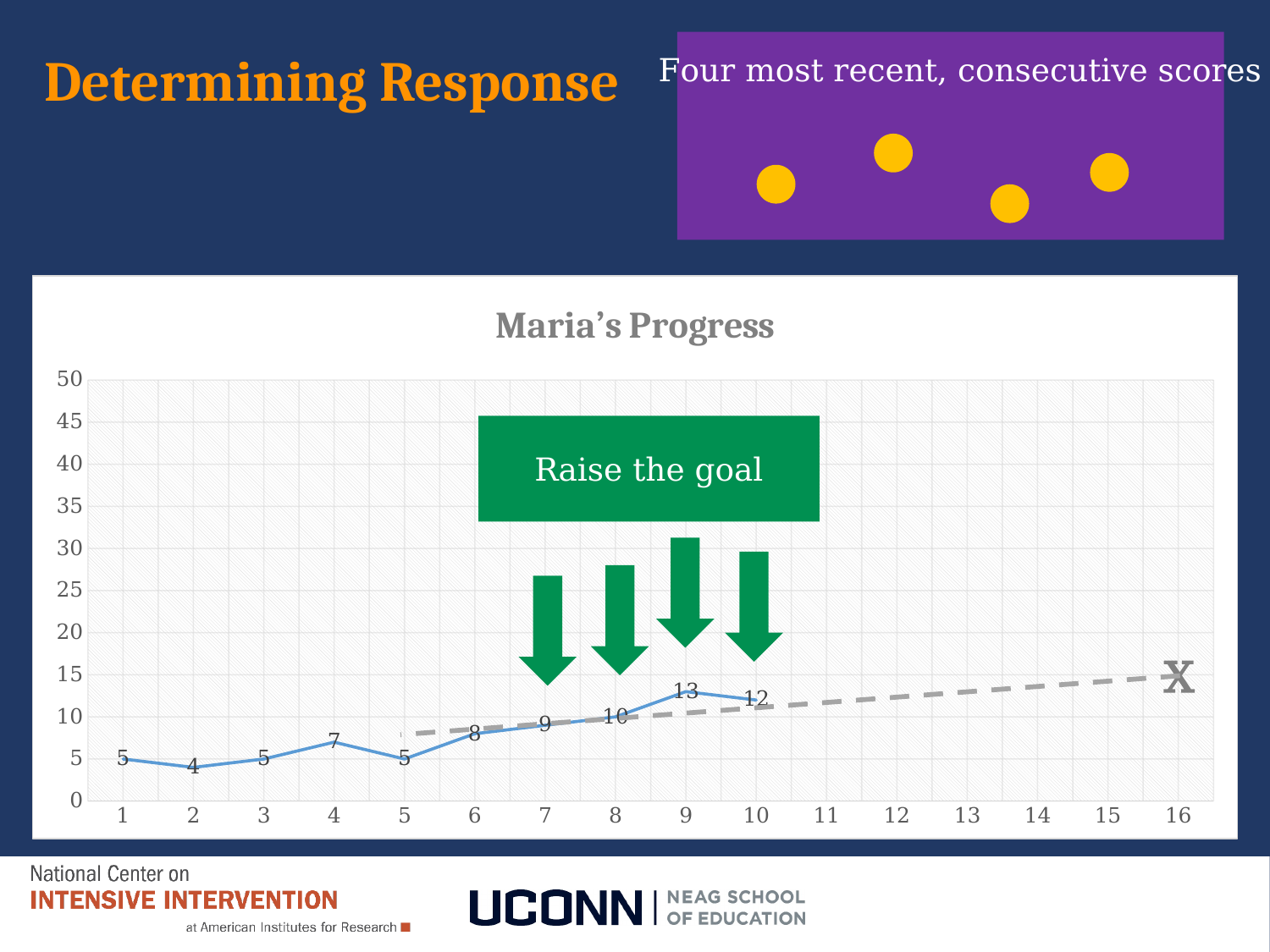
Is Maria's score at point 10 greater or less than 10? greater At which point is Maria's score lowest? 2 What is Maria's score at point 2? 4 At which point is Maria's score highest? 9 What is the difference between Maria's score at point 9 and her score at point 1? 8 What is Maria's score at point 6? 8 What is the title of the chart? Maria's Progress What is Maria's score at point 9? 13 How many data points are plotted on Maria's progress line? 10 Which is larger, Maria's score at point 4 or at point 5? point 4 Do Maria's scores generally rise or fall from point 5 to point 9? rise What kind of chart is shown on the slide? line chart